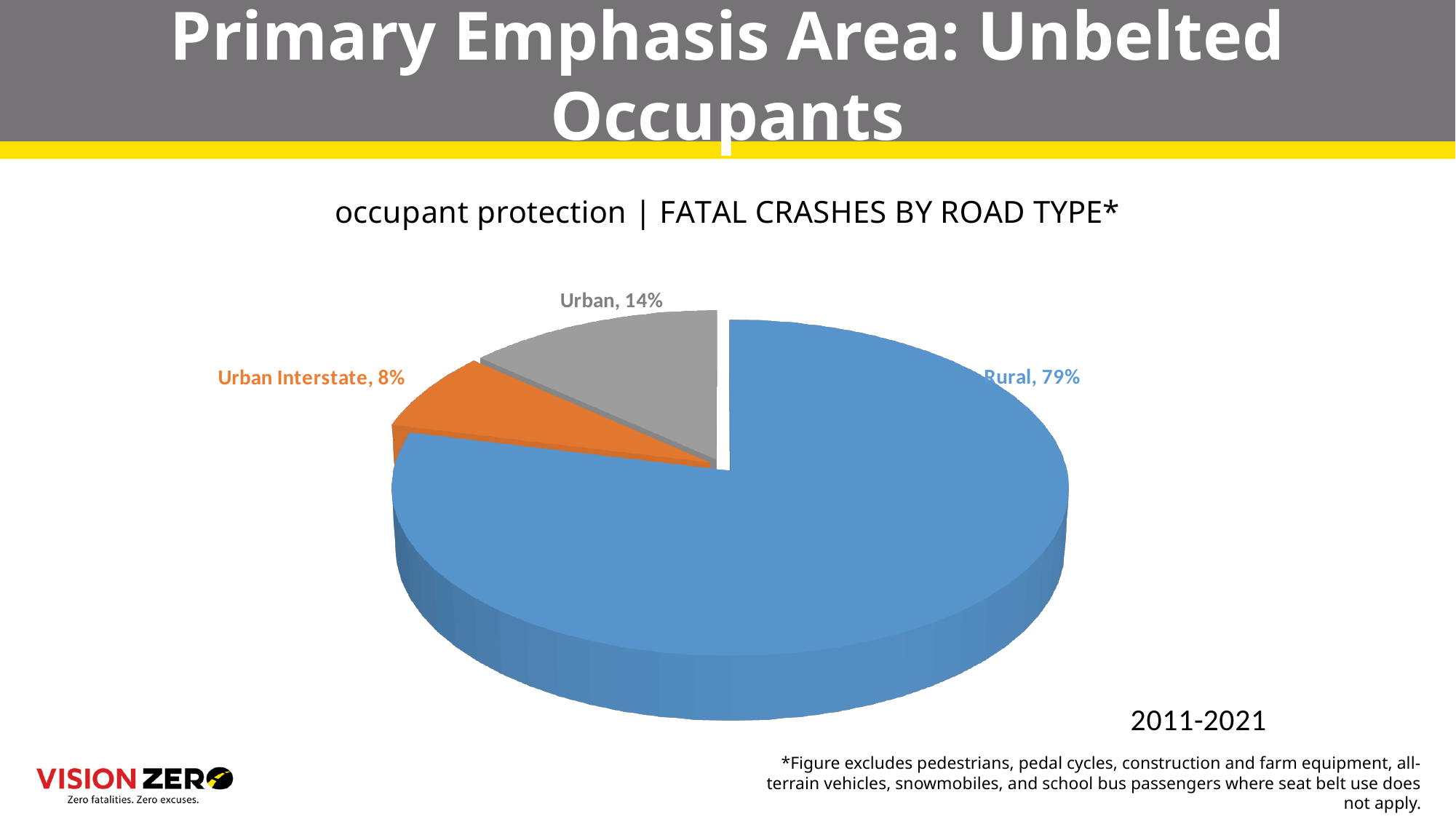
Which road type has the largest share of fatal crashes? Rural Which has a larger share of fatal crashes, Urban or Urban Interstate? Urban What kind of chart is shown on the slide? Pie chart What is the difference in percentage points between the Rural and Urban shares? 65 What is the difference in percentage points between the Urban and Urban Interstate shares? 6 What share of fatal crashes occurred on Urban roads? 14% What share of fatal crashes occurred on Rural roads? 79% How many road type categories are shown in the pie chart? 3 What time period does the chart cover? 2011-2021 Which road type has the smallest share of fatal crashes? Urban Interstate What share of fatal crashes occurred on Urban Interstate roads? 8% What is the title of the chart? occupant protection | FATAL CRASHES BY ROAD TYPE*